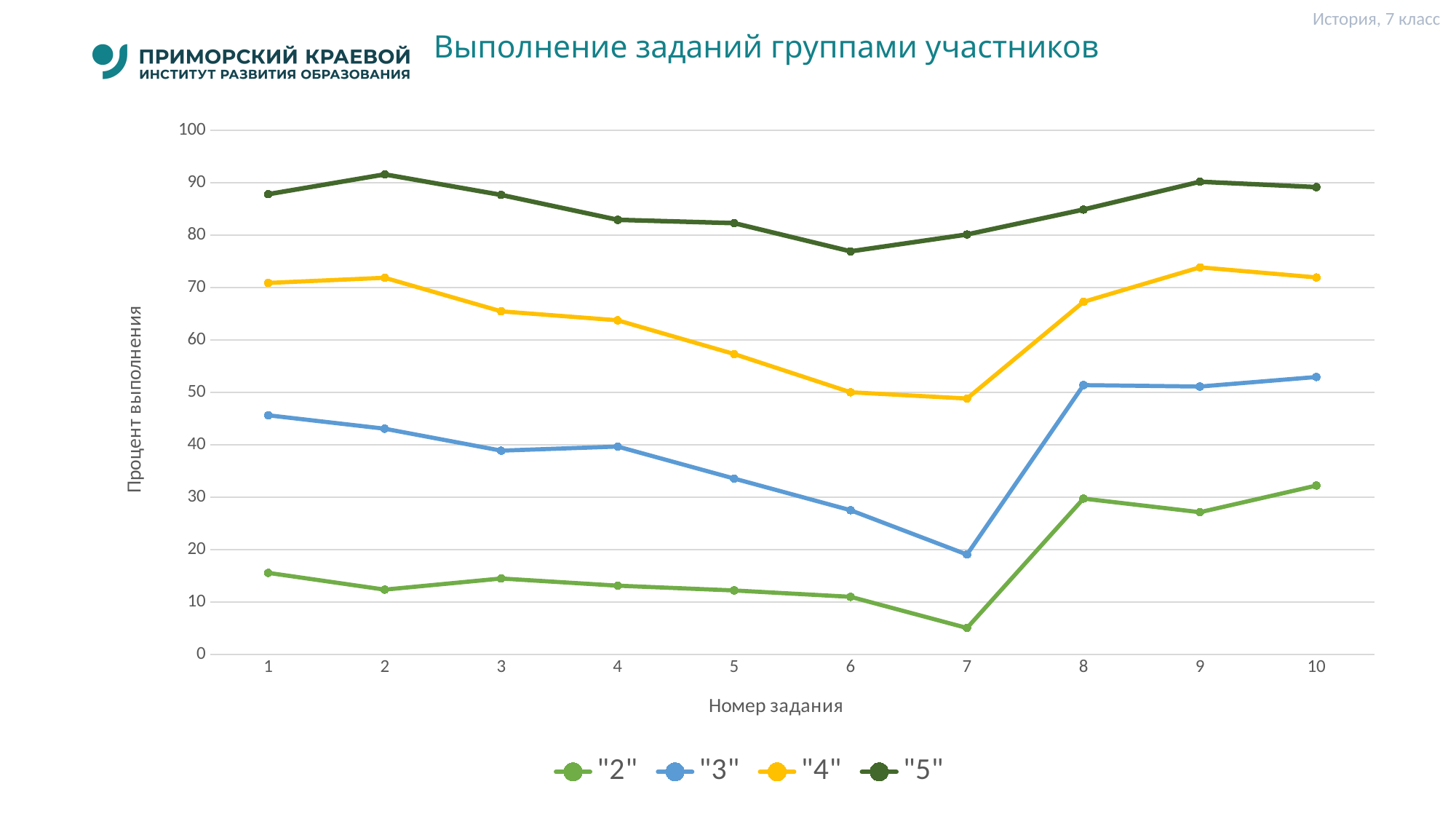
Is the value for series "4" at task 6 greater or less than 60? less What is the title of the chart? Выполнение заданий группами участников Is the value for series "2" at task 7 greater or less than 10? less How many task numbers are shown along the x axis? 10 Is the value for series "5" at task 6 greater or less than 80? less For series "3", at which task number is the value lowest? 7 What kind of chart is shown on the slide? Line chart How many series does the legend list? 4 For series "4", at which task number is the value highest? 9 Which series has the highest values across all tasks? "5" For series "2", is the value at task 8 or at task 9 larger? Task 8 Do the values for series "3" rise or fall from task 1 to task 7? Fall